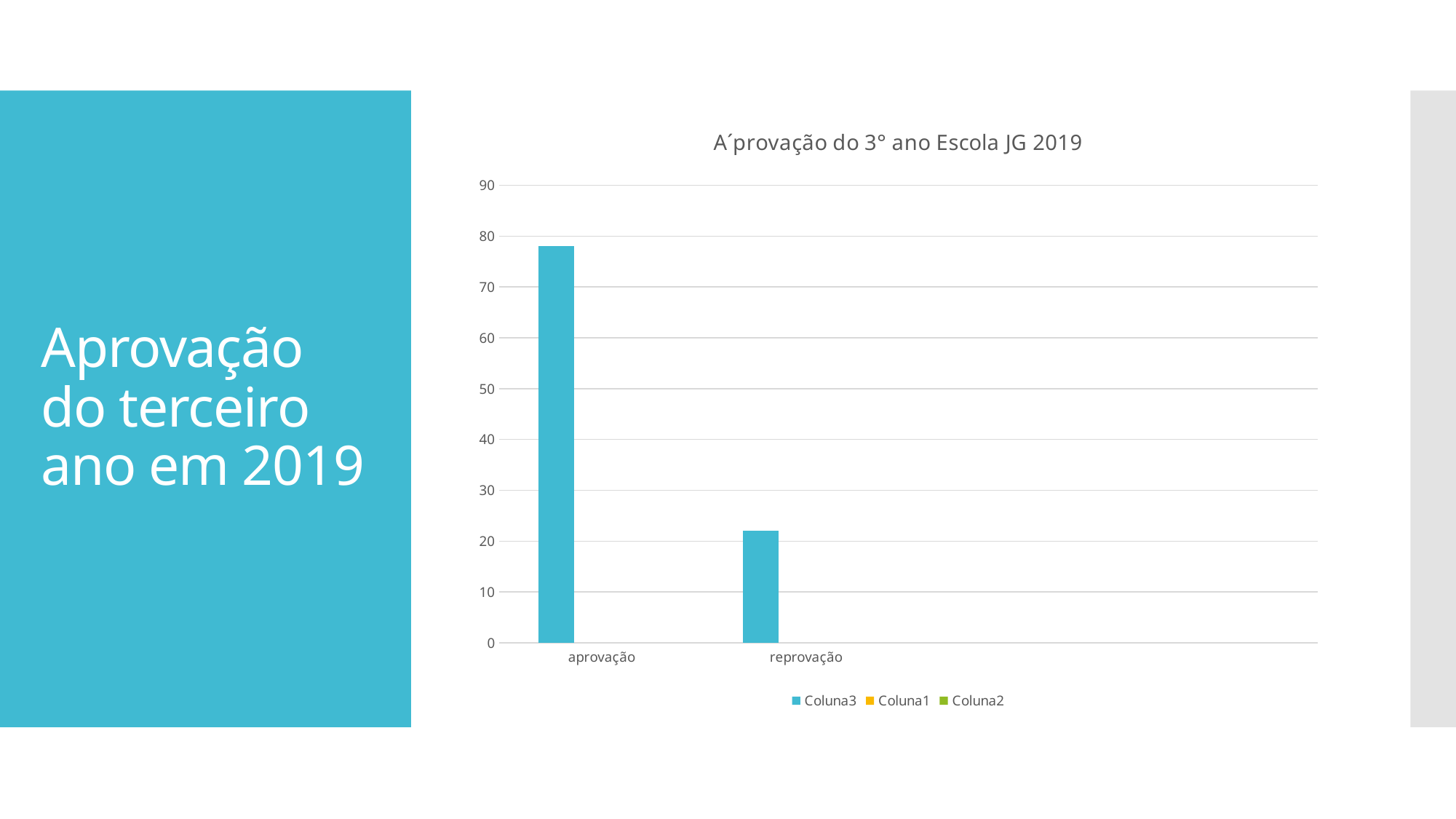
What is the title of the chart? A´provação do 3° ano Escola JG 2019 Is the value for aprovação greater or less than 90? less Which legend entry is shown in blue? Coluna3 What kind of chart is shown on the slide? bar chart Which category has the highest value in the chart? aprovação How many categories are shown on the x axis of the chart? 2 Is the value for aprovação greater or less than 70? greater Which is larger, the value for aprovação or the value for reprovação? aprovação Is the value for reprovação greater or less than 10? greater Which category has the lowest value in the chart? reprovação How many series does the chart legend list? 3